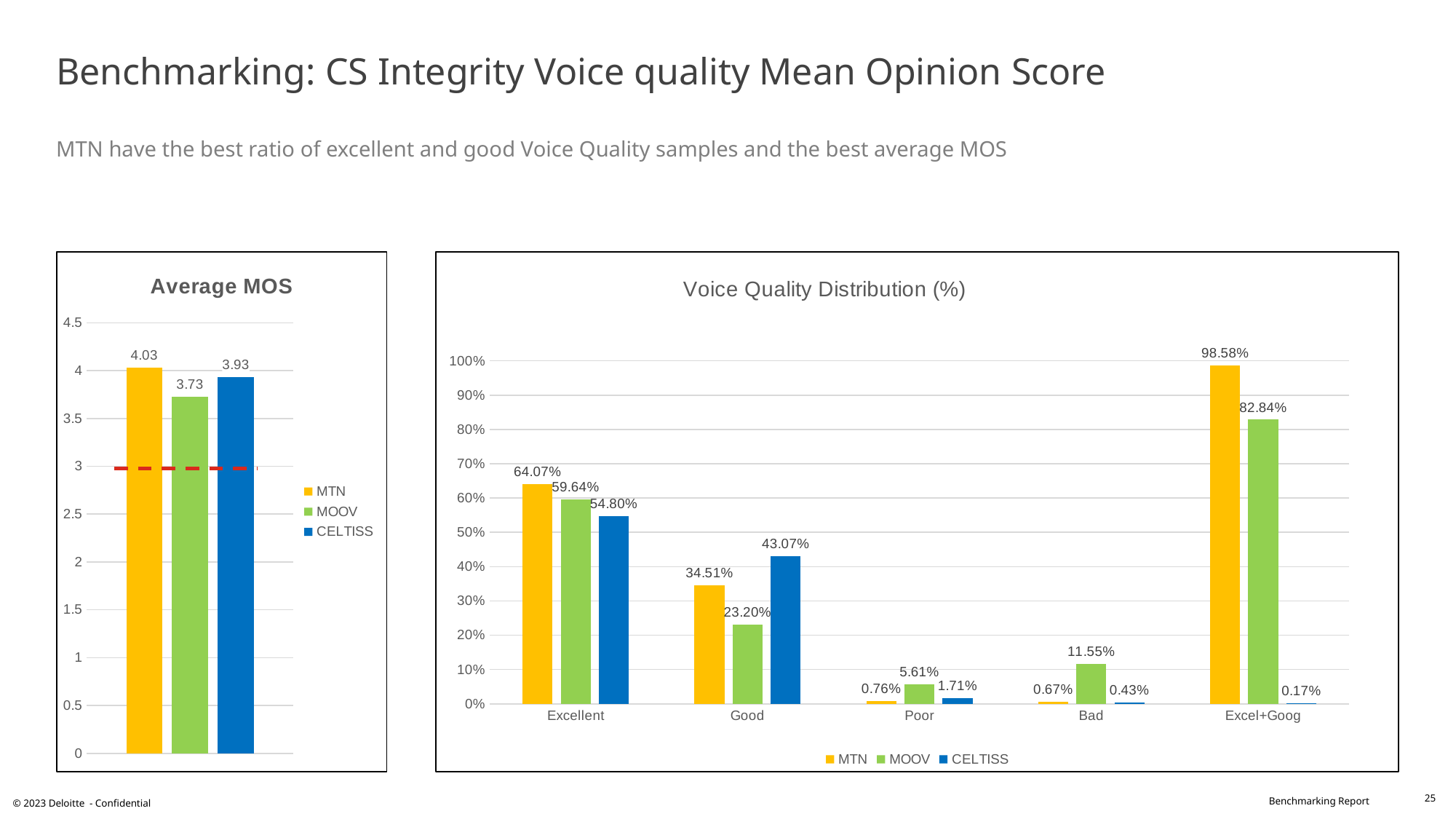
In the Average MOS chart, what is the difference between the MTN and CELTISS values? 0.10 In the Average MOS chart, what is the value for MTN? 4.03 In the Average MOS chart, which operator has the lowest average MOS? MOOV In the Voice Quality Distribution (%) chart, is the value for MTN in the Good category greater or less than 30%? greater In the Voice Quality Distribution (%) chart, which is larger in the Poor category: MOOV or CELTISS? MOOV In the Voice Quality Distribution (%) chart, what is the value for CELTISS in the Good category? 43.07% How many categories are shown on the x axis of the Voice Quality Distribution (%) chart? 5 In the Voice Quality Distribution (%) chart, what is the difference between MTN and MOOV in the Excel+Goog category? 15.74% What kind of chart is the Average MOS chart? Bar chart In the Voice Quality Distribution (%) chart, which operator has the highest value in the Excellent category? MTN In the Voice Quality Distribution (%) chart, what is the value for MOOV in the Bad category? 11.55% How many series does the legend of the Voice Quality Distribution (%) chart list? 3